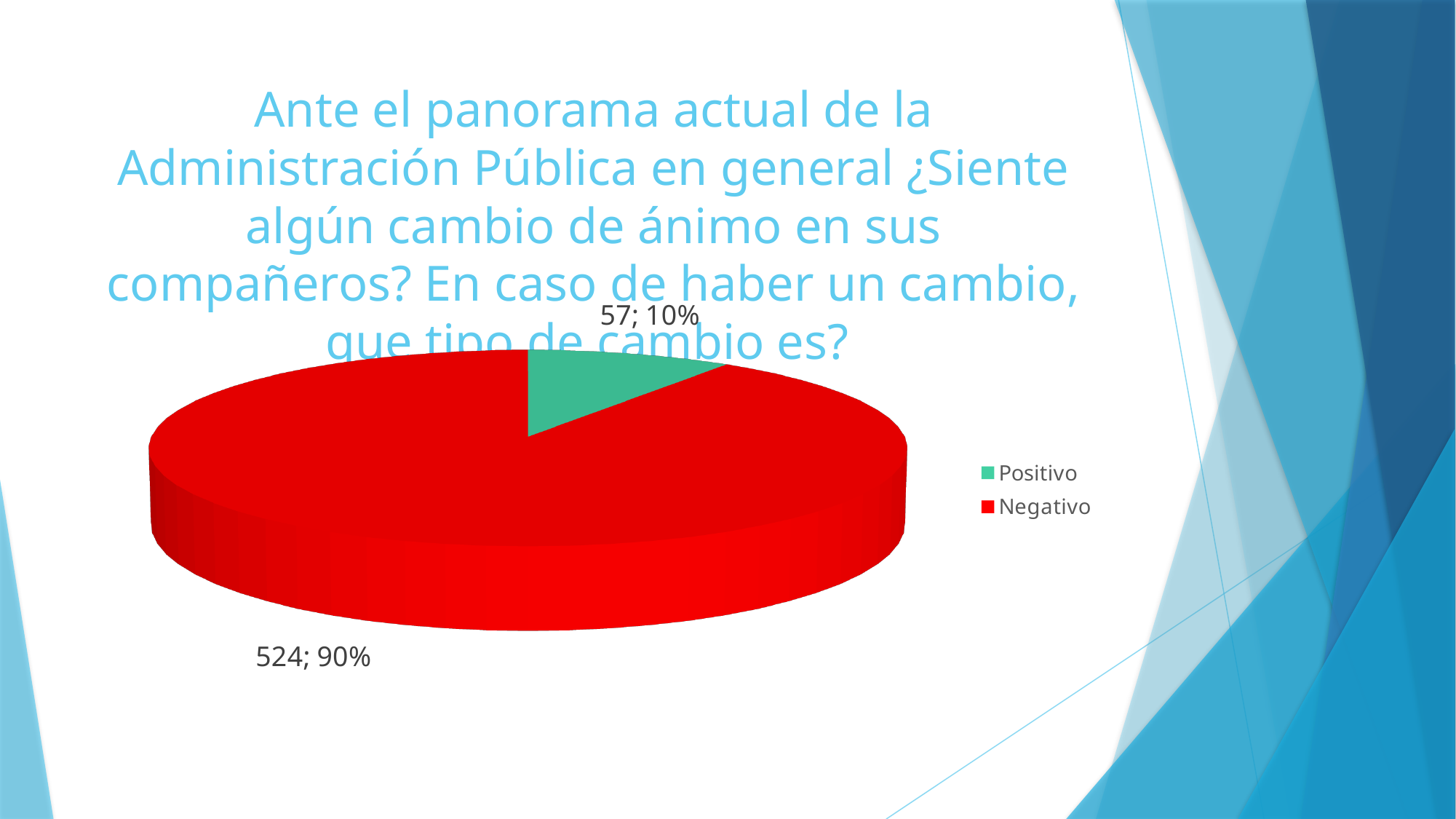
What colour is the Positivo slice? green What share of the pie does Positivo represent? 10% Which category has the smallest slice? Positivo What share of the pie does Negativo represent? 90% What is the difference between the counts for Negativo and Positivo? 467 What is the count for Negativo? 524 Which is larger, the count for Positivo or the count for Negativo? Negativo What kind of chart is shown on the slide? pie chart How many slices does the pie chart have? 2 How many entries does the legend list? 2 Which category has the largest slice? Negativo What is the count for Positivo? 57